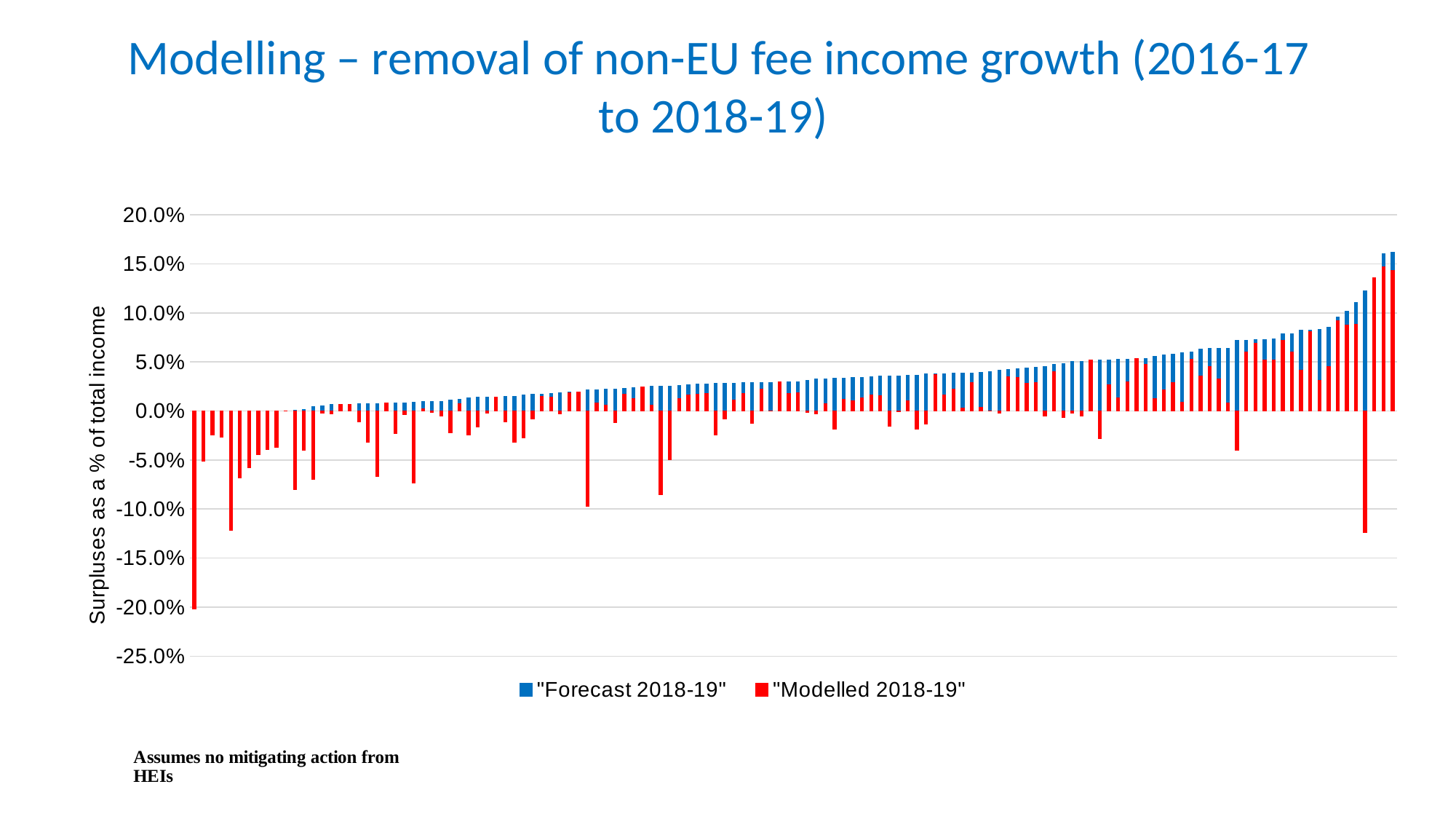
What kind of chart is shown on the slide? bar chart Do the Forecast 2018-19 values rise or fall from left to right along the x axis? rise Is the highest value in the Forecast 2018-19 series greater or less than 15.0%? greater Is the lowest value in the Modelled 2018-19 series greater or less than -15.0%? less Which series contains the highest value plotted on the chart? Forecast 2018-19 How many series does the legend list? 2 What is the title of the vertical axis? Surpluses as a % of total income Is the lowest value in the Forecast 2018-19 series greater or less than -5.0%? less What are the two series named in the legend? "Forecast 2018-19" and "Modelled 2018-19"